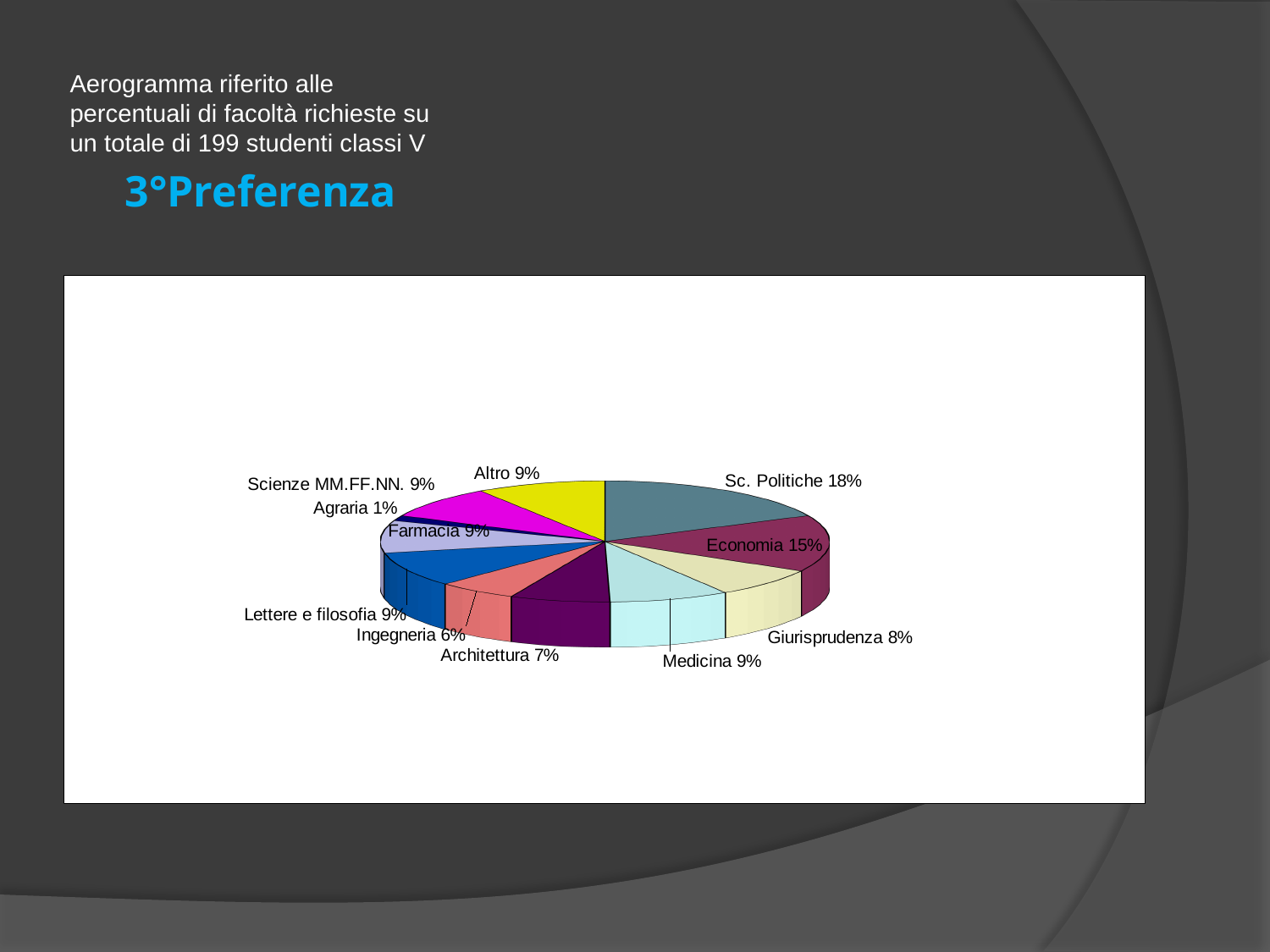
Which faculty has the largest slice of the pie? Sc. Politiche What percentage is shown for Ingegneria? 6% Which faculty has the smallest slice of the pie? Agraria What is the difference in percentage points between Sc. Politiche and Economia? 3 Which is larger, Architettura or Giurisprudenza? Giurisprudenza What is the difference in percentage points between Giurisprudenza and Ingegneria? 2 What kind of chart is shown on the slide? Pie chart How many slices does the pie chart have? 11 What is the heading shown above the chart? 3°Preferenza What percentage is shown for Sc. Politiche? 18% What percentage is shown for Economia? 15% What percentage is shown for Agraria? 1%